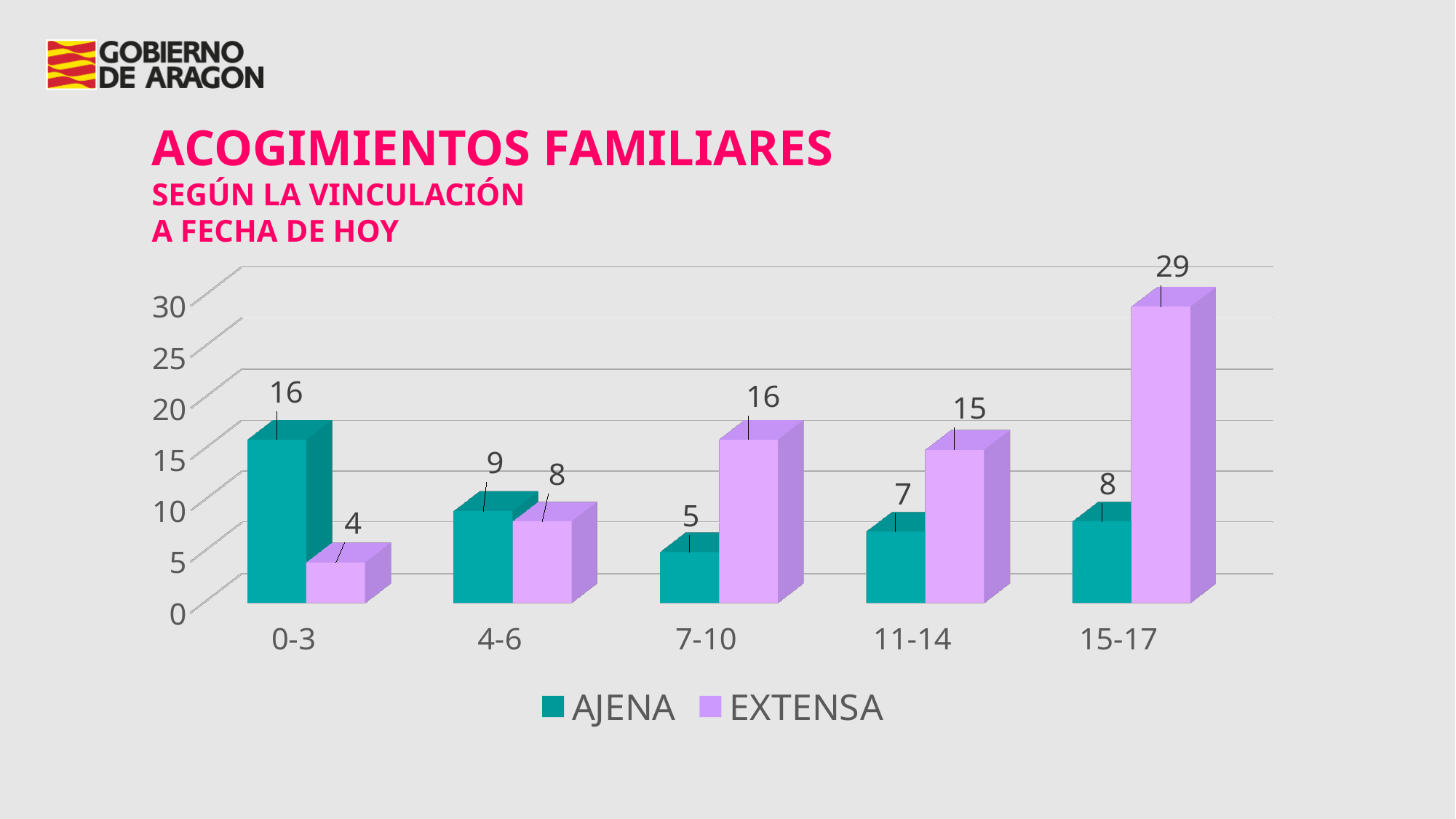
What is the difference between the EXTENSA and AJENA values for the 15-17 age group? 21 What kind of chart is shown on the slide? Bar chart Which age group has the lowest AJENA value? 7-10 Which age group has the highest EXTENSA value? 15-17 How many age groups are shown on the x axis? 5 What is the EXTENSA value for the 15-17 age group? 29 How many series does the legend list? 2 What is the AJENA value for the 0-3 age group? 16 What colour represents the AJENA series in the legend? Teal For the 4-6 age group, which series has the larger value, AJENA or EXTENSA? AJENA What is the EXTENSA value for the 7-10 age group? 16